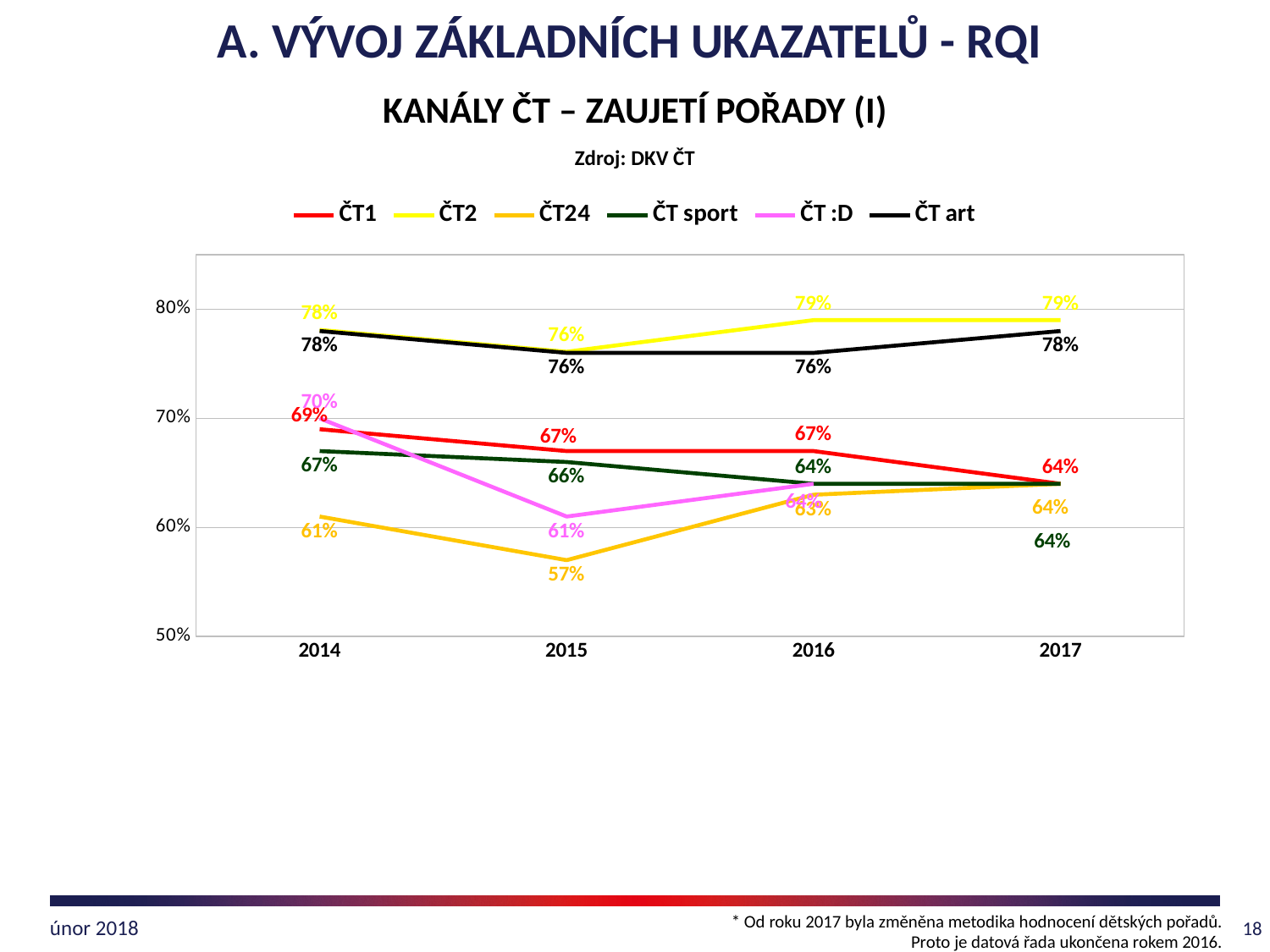
What is the value for ČT2 in 2016? 79% What is the value for ČT24 in 2015? 57% What is the value for ČT :D in 2014? 70% Which series has the lowest value in 2015? ČT24 What kind of chart is shown on the slide? line chart Which series has the highest value in 2017? ČT2 How many series does the legend list? 6 What is the difference between ČT1 and ČT24 in 2014? 8% What is the source stated below the chart title? DKV ČT How many years are shown on the x axis? 4 Does the ČT1 line rise or fall from 2014 to 2017? fall Which is larger in 2015, ČT1 or ČT :D? ČT1